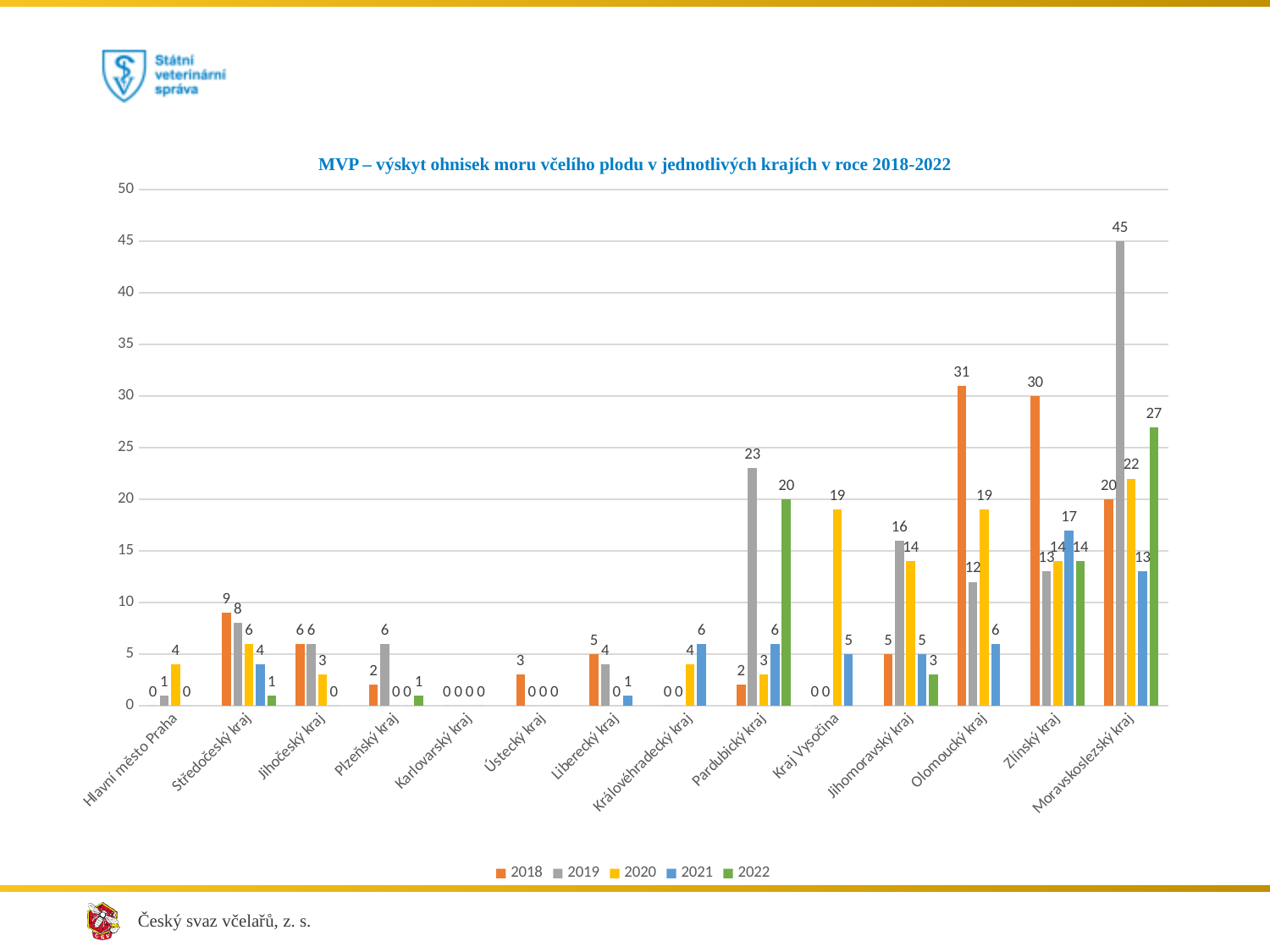
Which region has the highest value in the 2018 series? Olomoucký kraj How many regions are shown on the x axis? 14 What is the difference between the 2019 and 2022 values for Moravskoslezský kraj? 18 Is the 2019 value for Moravskoslezský kraj greater or less than 40? greater What is the value for Pardubický kraj in 2019? 23 What kind of chart is shown on the slide? bar chart Which region has the highest value in the 2022 series? Moravskoslezský kraj How many series does the legend list? 5 Which is larger: the 2018 value for Zlínský kraj or the 2018 value for Středočeský kraj? Zlínský kraj What is the value for Moravskoslezský kraj in 2019? 45 What is the value for Olomoucký kraj in 2018? 31 What is the value for Kraj Vysočina in 2020? 19